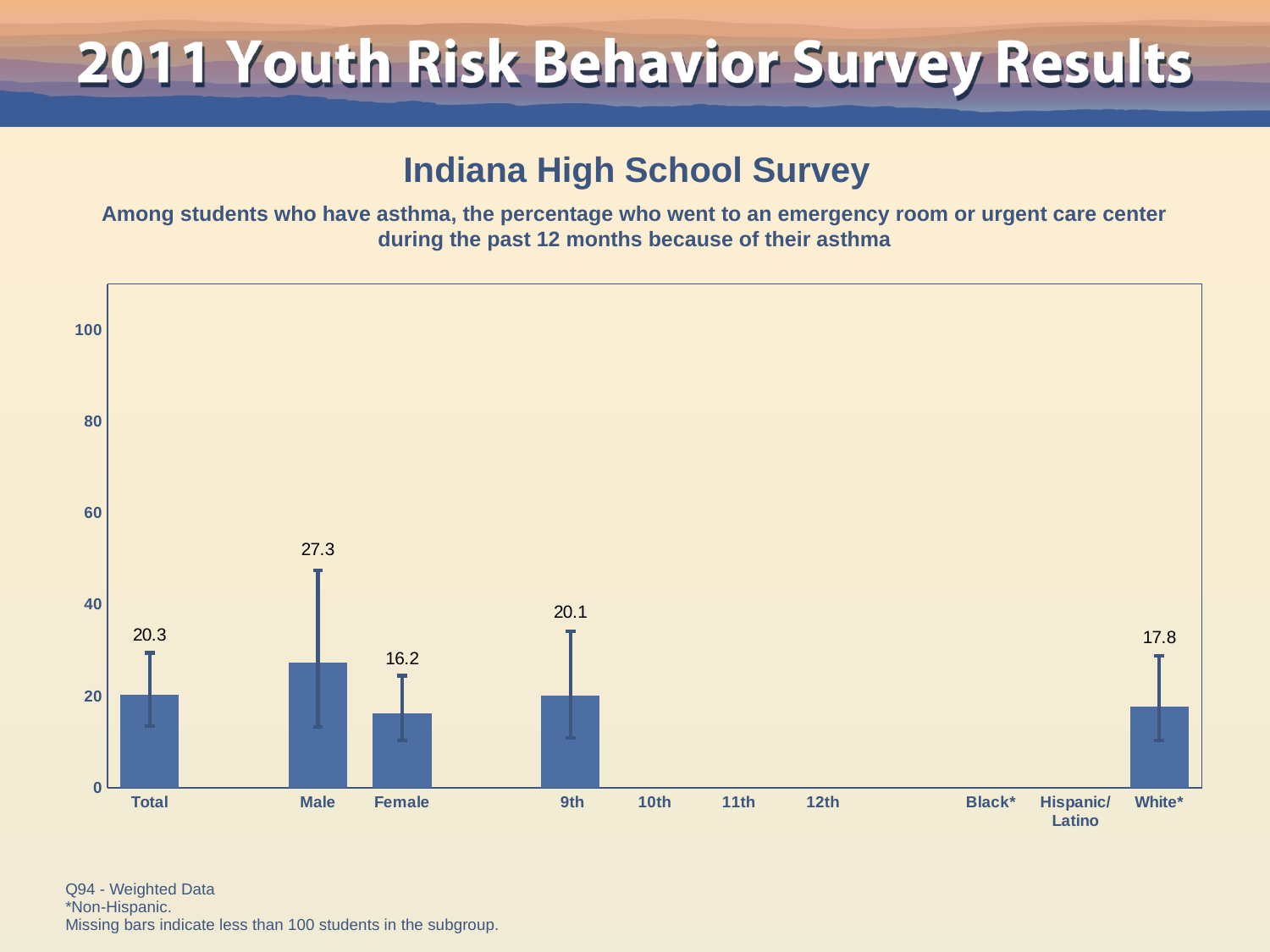
Which category has the lowest value among the bars shown? Female What kind of chart is shown? Bar chart What is the value for White*? 17.8 Is the value for Male greater or less than 20? greater Which categories on the x axis have no bar plotted? 10th, 11th, 12th, Black*, Hispanic/Latino What is the value for Female? 16.2 What is the value for Male? 27.3 Which category has the highest value among the bars shown? Male How many categories have a bar plotted? 5 What is the value for Total? 20.3 Which is larger, the value for 9th or the value for White*? 9th What is the difference between the Male and Female values? 11.1